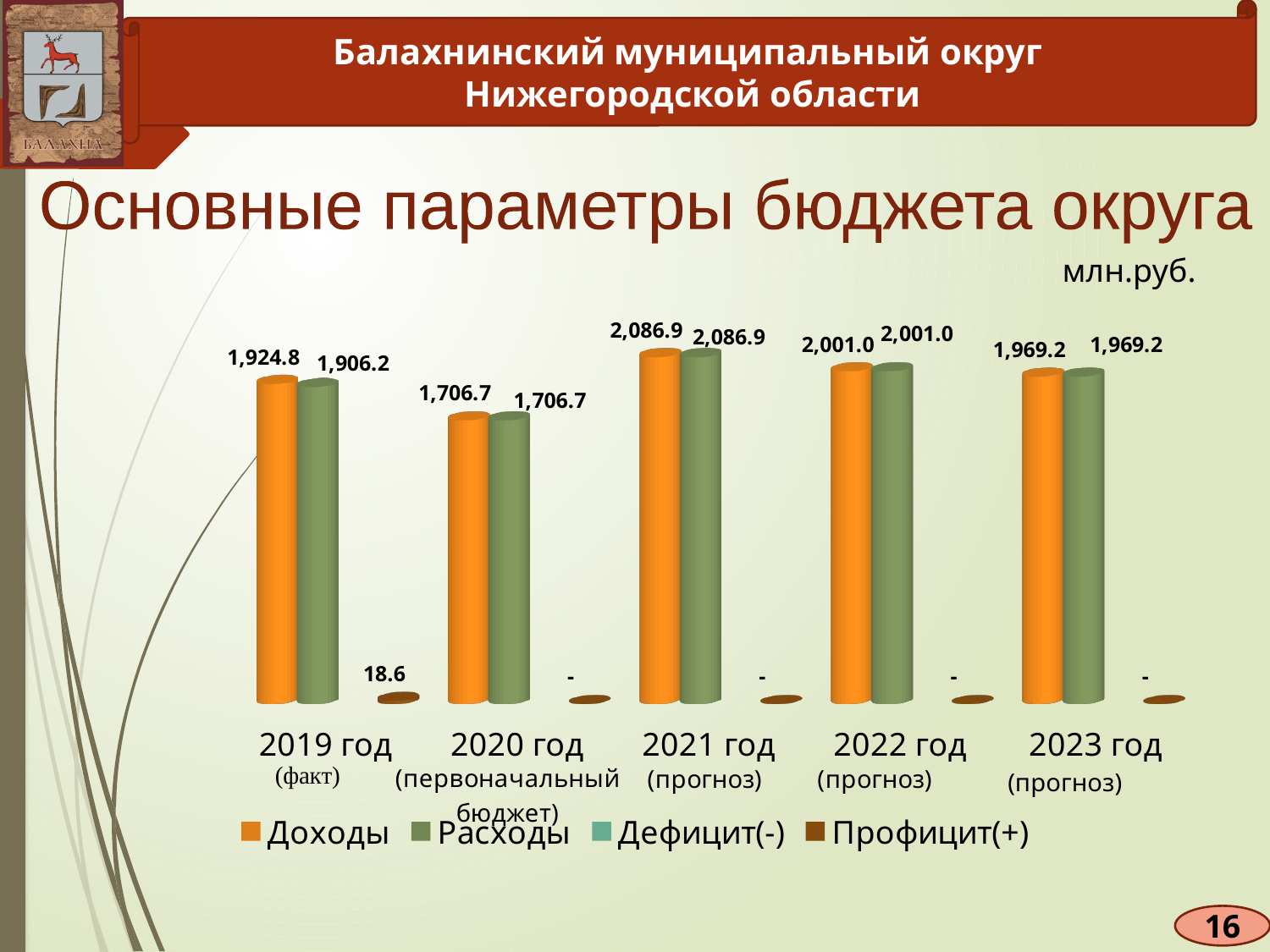
In which year is Доходы the highest? 2021 год What is the difference between Доходы and Расходы in 2019 год? 18.6 What is the value of Доходы for 2019 год? 1,924.8 What kind of chart is shown on the slide? Bar chart What is the value of Профицит(+) for 2019 год? 18.6 What is the value of Расходы for 2019 год? 1,906.2 How many year categories are shown on the x axis? 5 What unit is stated for the chart values? млн.руб. How many series does the legend list? 4 Which is larger in 2019 год, Доходы or Расходы? Доходы In which year is Доходы the lowest? 2020 год What is the value of Доходы for 2021 год? 2,086.9